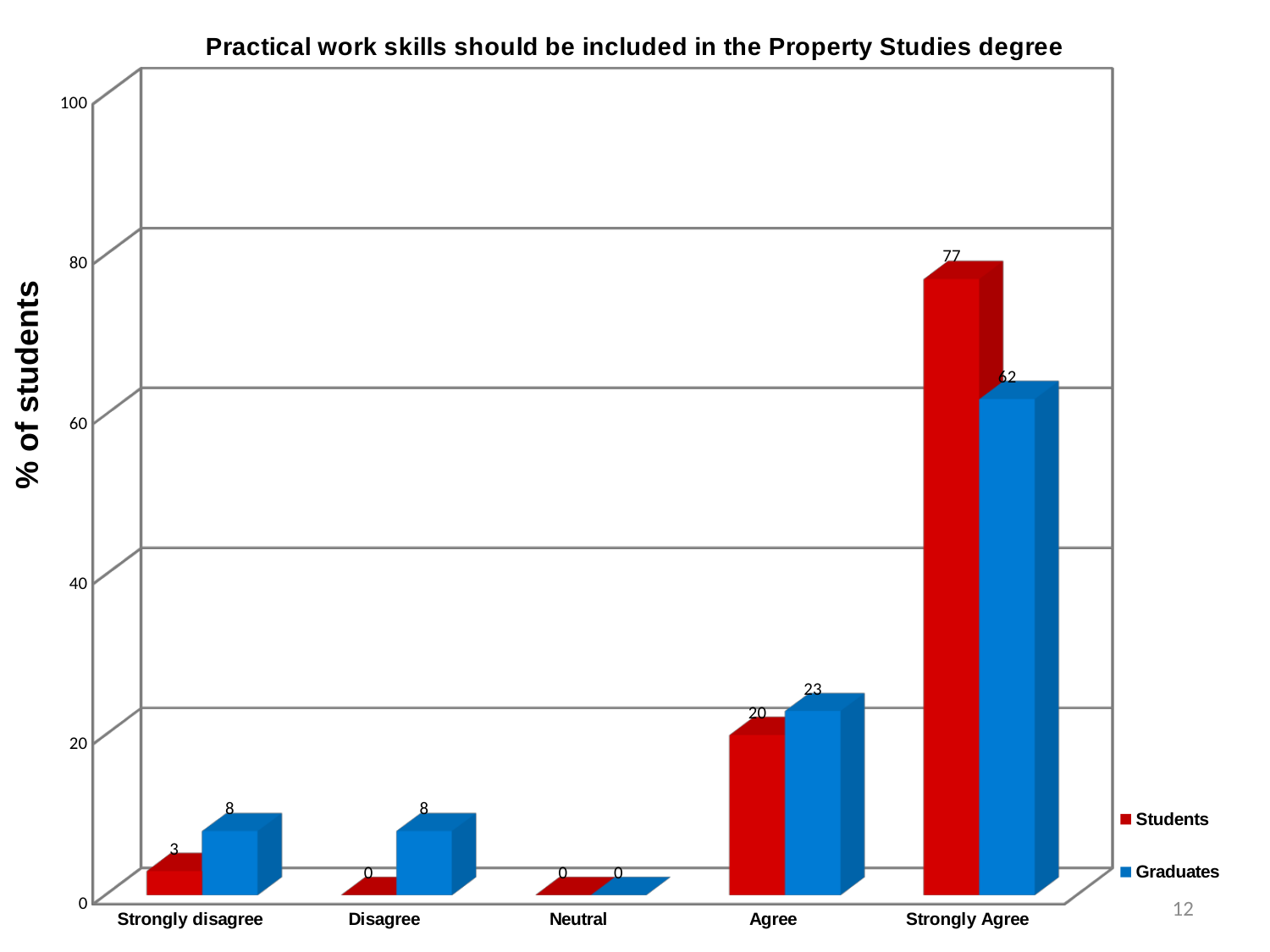
In the Agree category, which series has the larger value, Students or Graduates? Graduates What kind of chart is shown on the slide? bar chart How many categories are shown on the x axis? 5 How many series does the legend list? 2 What is the value for Students in the Strongly Agree category? 77 What is the value for Students in the Strongly disagree category? 3 What is the value for Graduates in the Agree category? 23 Which category has the lowest value for Graduates? Neutral What is the value for Graduates in the Disagree category? 8 Is the value for Graduates in the Strongly Agree category greater or less than 80? less Which category has the highest value for Students? Strongly Agree What is the difference between the Students and Graduates values in the Strongly Agree category? 15